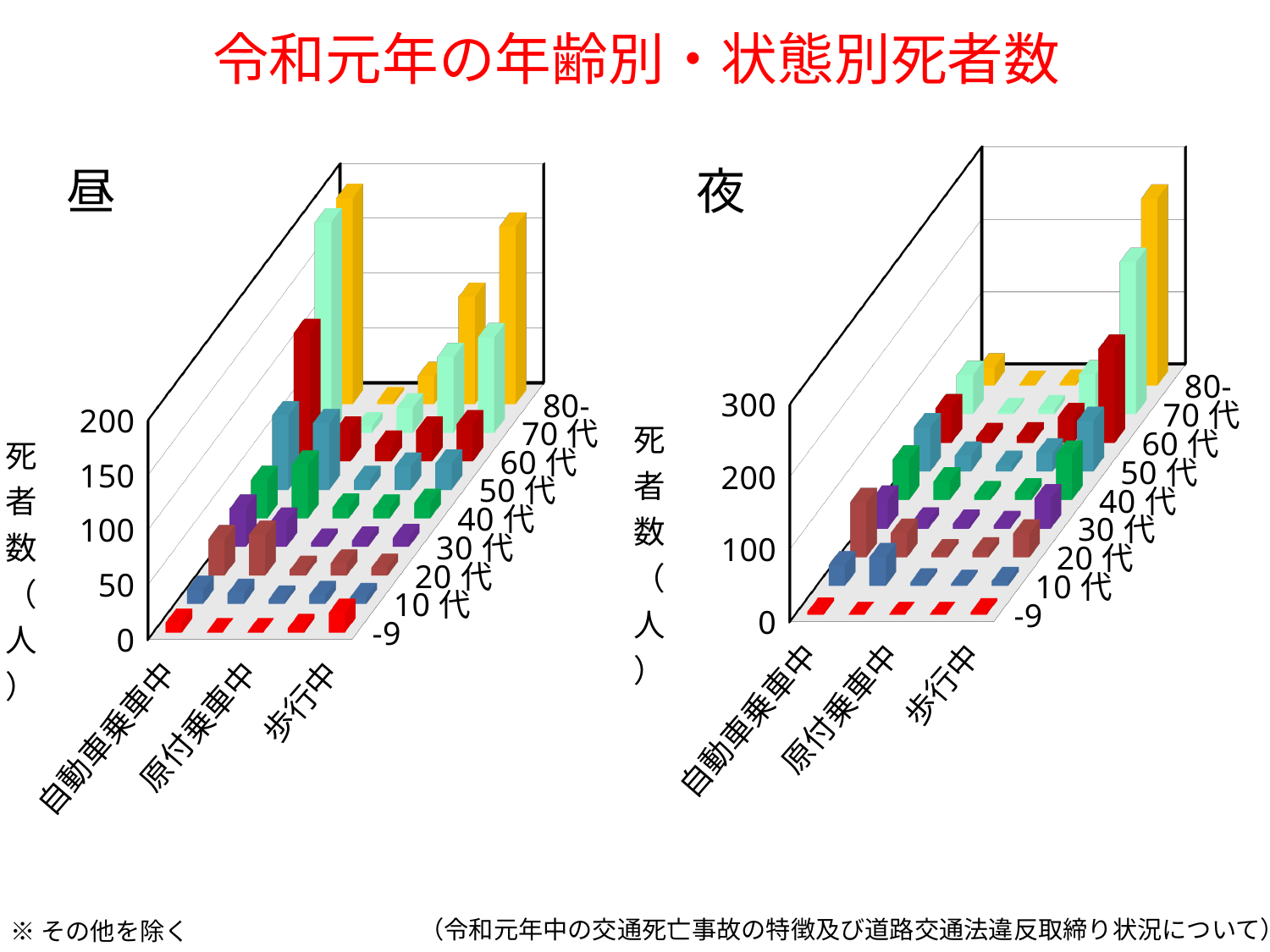
How many age groups are shown along the depth axis of the 夜 chart? 9 In the 昼 chart, which category has the tallest bar for the 80- age group? 自動車乗車中 In the 昼 chart, is the value for 歩行中 in the 80- age group greater or less than 100? greater What is the highest tick value shown on the vertical axis of the 夜 chart? 300 In the 昼 chart, which age group has the tallest bar for 歩行中? 80- What is the title of the slide's charts? 令和元年の年齢別・状態別死者数 How many categories are shown along the front axis of the 昼 chart? 5 What kind of chart is the 夜 chart? 3D bar chart In the 夜 chart, which age group has the tallest bar for 歩行中? 80- What kind of chart is the 昼 chart? 3D bar chart In the 夜 chart, is the value for 原付乗車中 in the -9 age group greater or less than 100? less In the 夜 chart, is the value for 歩行中 in the 80- age group greater or less than 100? greater